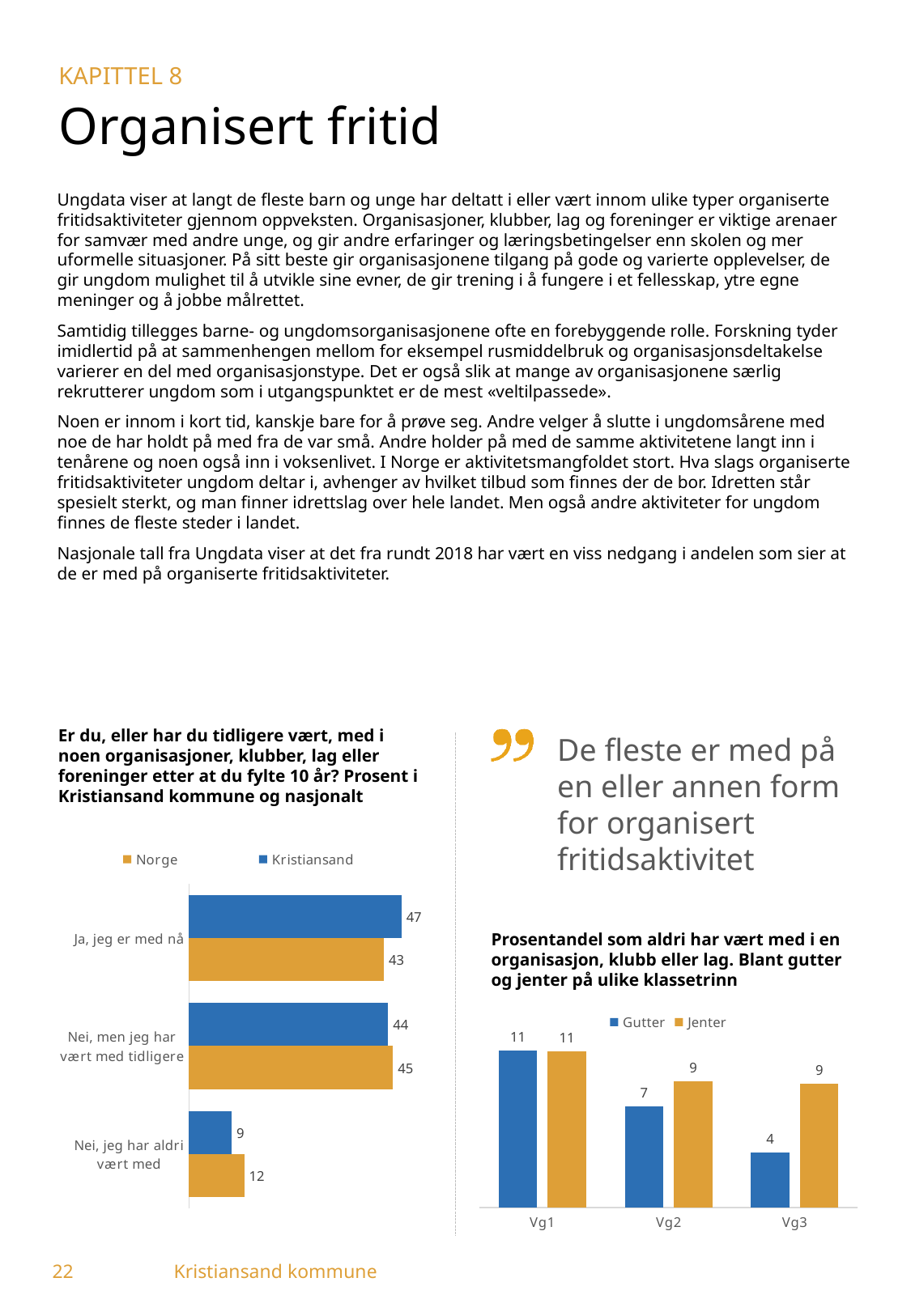
In the left chart (Er du, eller har du tidligere vært, med i noen organisasjoner...), what is the difference between Kristiansand and Norge for 'Ja, jeg er med nå'? 4 In the left chart (Er du, eller har du tidligere vært, med i noen organisasjoner...), what is the value for Norge for 'Nei, jeg har aldri vært med'? 12 In the left chart (Er du, eller har du tidligere vært, med i noen organisasjoner...), how many categories are shown? 3 What kind of chart is the left chart (Er du, eller har du tidligere vært, med i noen organisasjoner...)? Bar chart In the right chart (Prosentandel som aldri har vært med i en organisasjon, klubb eller lag), do the values for Gutter rise or fall from Vg1 to Vg3? Fall In the right chart (Prosentandel som aldri har vært med i en organisasjon, klubb eller lag), which class level has the lowest value for Gutter? Vg3 In the left chart (Er du, eller har du tidligere vært, med i noen organisasjoner...), what is the value for Kristiansand for 'Ja, jeg er med nå'? 47 In the right chart (Prosentandel som aldri har vært med i en organisasjon, klubb eller lag), what is the difference between Jenter and Gutter at Vg3? 5 In the left chart (Er du, eller har du tidligere vært, med i noen organisasjoner...), which is larger for 'Nei, men jeg har vært med tidligere': Norge or Kristiansand? Norge In the right chart (Prosentandel som aldri har vært med i en organisasjon, klubb eller lag), what is the value for Gutter at Vg3? 4 In the left chart (Er du, eller har du tidligere vært, med i noen organisasjoner...), how many series does the legend list? 2 In the right chart (Prosentandel som aldri har vært med i en organisasjon, klubb eller lag), what is the value for Jenter at Vg2? 9